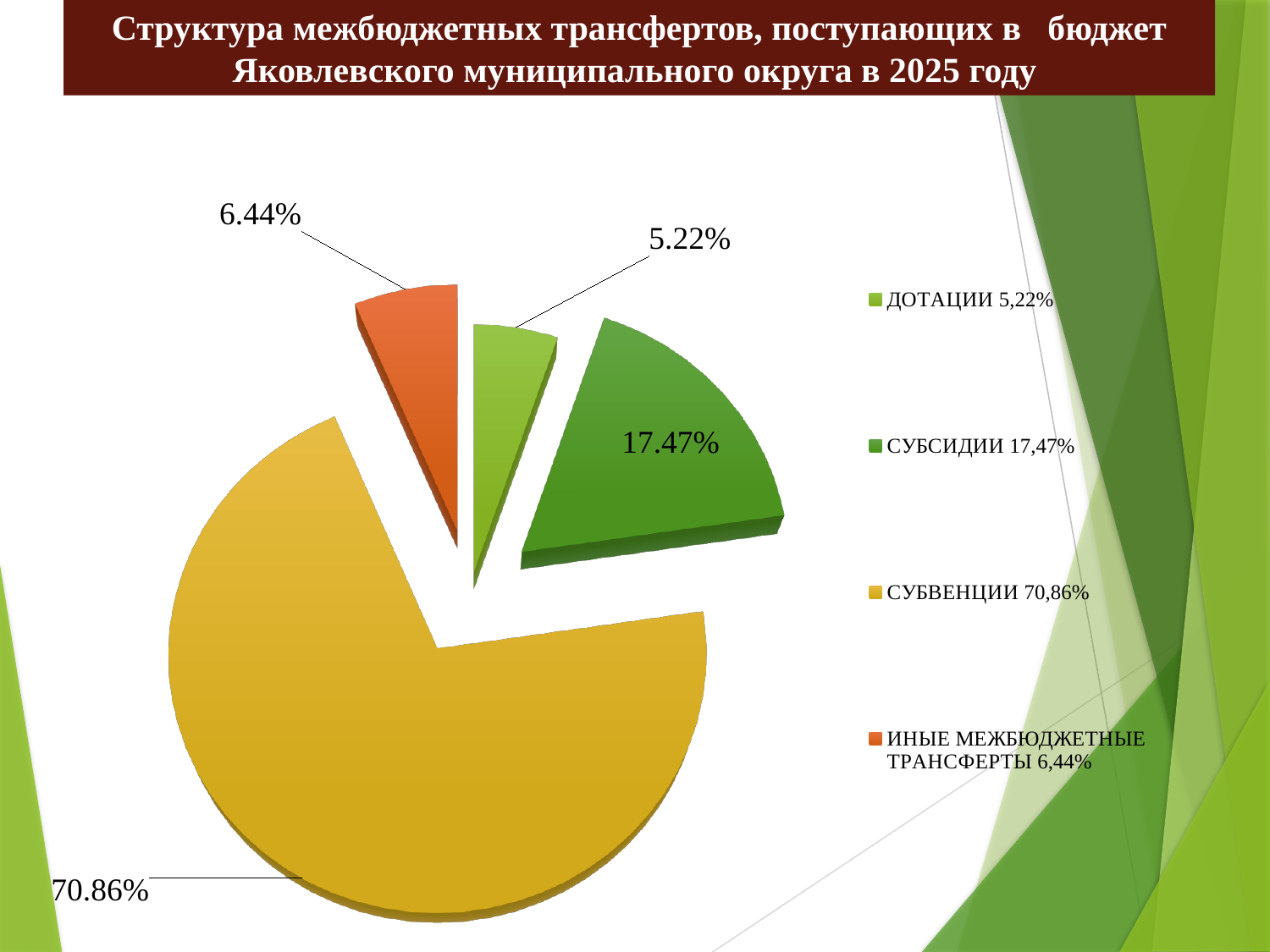
What is the value shown for ИНЫЕ МЕЖБЮДЖЕТНЫЕ ТРАНСФЕРТЫ? 6.44% How many entries does the legend list? 4 Which category has the largest slice of the pie? СУБВЕНЦИИ Which is larger, the share of ИНЫЕ МЕЖБЮДЖЕТНЫЕ ТРАНСФЕРТЫ or the share of ДОТАЦИИ? ИНЫЕ МЕЖБЮДЖЕТНЫЕ ТРАНСФЕРТЫ What is the value shown for СУБСИДИИ? 17.47% What type of chart is shown on the slide? Pie chart What share of the pie does СУБВЕНЦИИ have? 70.86% Which category has the smallest slice of the pie? ДОТАЦИИ What colour is the slice for СУБВЕНЦИИ? Yellow What is the value shown for ДОТАЦИИ? 5.22% What is the difference between the shares of СУБСИДИИ and ДОТАЦИИ? 12.25% How many slices does the pie chart have? 4